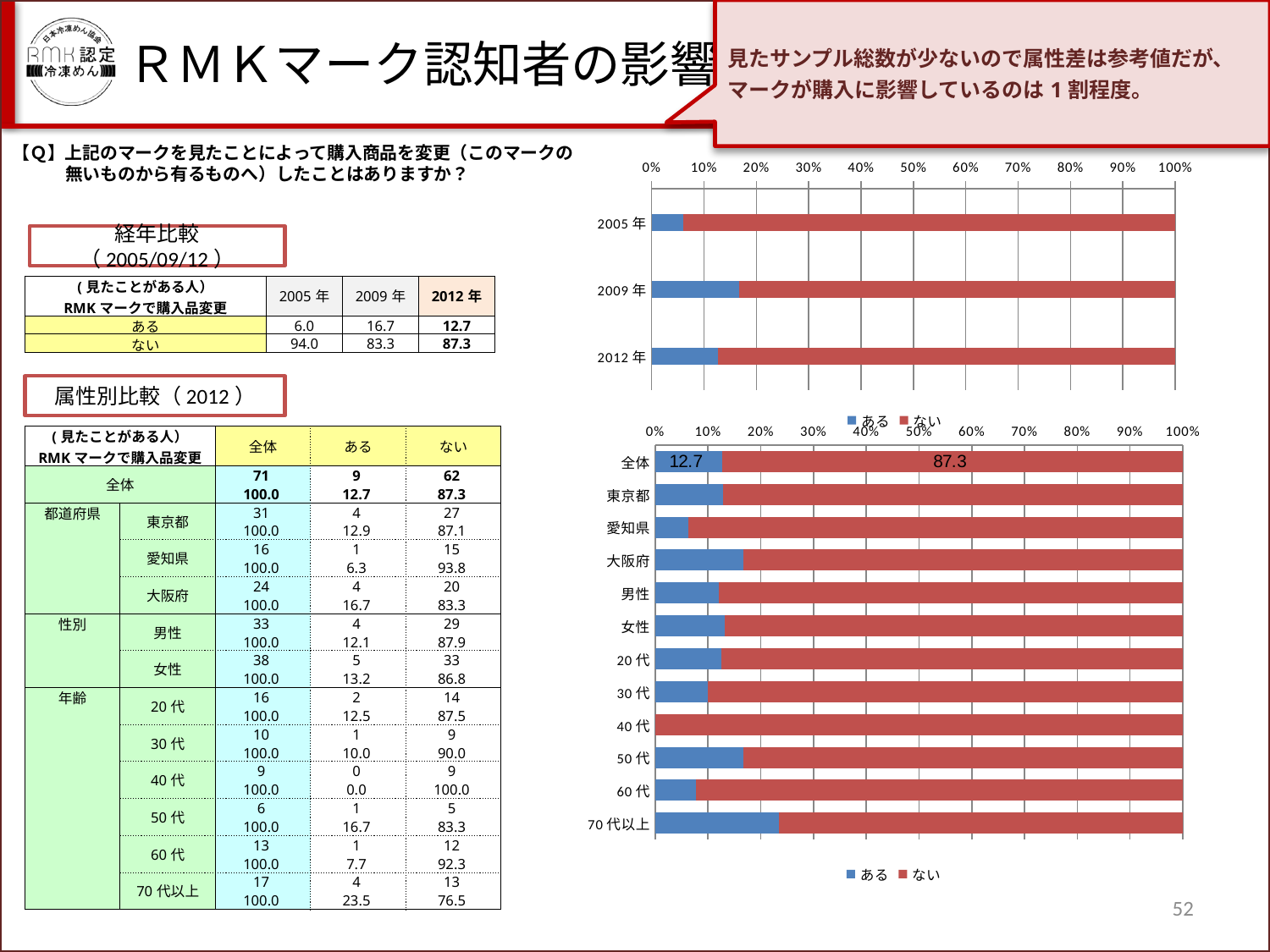
In the bottom chart (属性別比較 2012), is the ある value for 愛知県 greater or less than 10%? less In the bottom chart (属性別比較 2012), what is the data label for ない on the 全体 bar? 87.3 In the bottom chart (属性別比較 2012), which has the larger ある segment, 大阪府 or 東京都? 大阪府 In the bottom chart (属性別比較 2012), is the ある value for 70代以上 greater or less than 20%? greater How many categories are plotted in the bottom chart (属性別比較 2012)? 12 In the bottom chart (属性別比較 2012), which category has no visible ある segment (the smallest)? 40代 In the bottom chart (属性別比較 2012), what is the data label for ある on the 全体 bar? 12.7 In the top chart (経年比較), which year has the largest ある segment? 2009年 How many series does the legend of the bottom chart list, and what kind of chart is it? 2 series; bar chart In the bottom chart (属性別比較 2012), which category has the largest ある segment? 70代以上 In the top chart (経年比較), is the ある value for 2005年 greater or less than 10%? less In the bottom chart (属性別比較 2012), what is the total of the 全体 stacked bar (ある plus ない)? 100.0